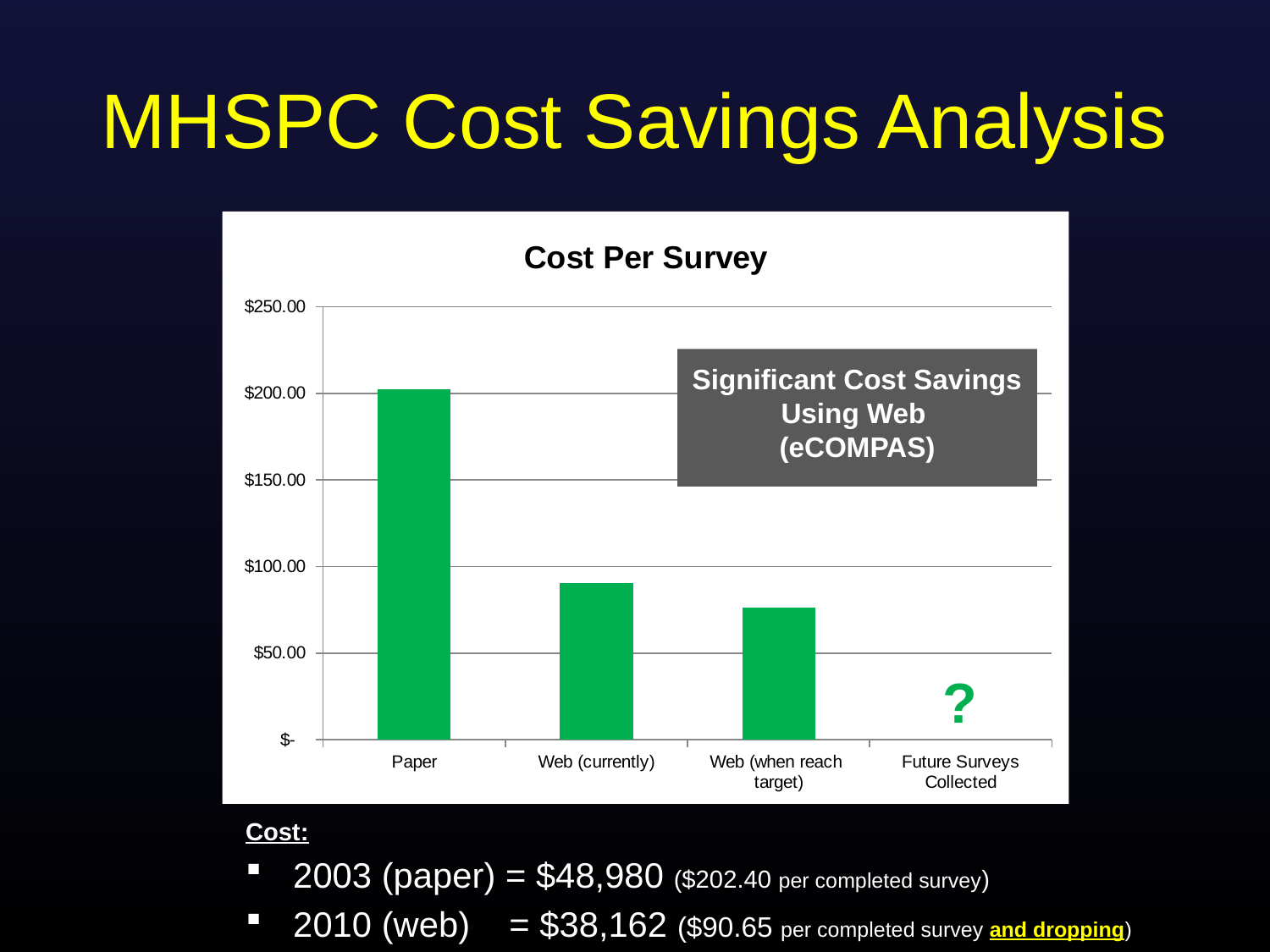
How many categories are shown on the x axis of the chart? 4 Which is larger, the cost per survey for Paper or for Web (currently)? Paper Which of the plotted bars has the lowest cost per survey? Web (when reach target) According to the slide, what is the cost per completed survey for paper (2003)? $202.40 Is the cost per survey for Paper greater or less than $150.00? greater Is the cost per survey for Web (currently) greater or less than $100.00? less What symbol is shown in place of a bar for Future Surveys Collected? ? What is the title of the chart? Cost Per Survey What kind of chart is shown on the slide? bar chart Do the bar values rise or fall from Paper to Web (when reach target)? fall Which category has the highest cost per survey? Paper Is the cost per survey for Web (when reach target) greater or less than $50.00? greater